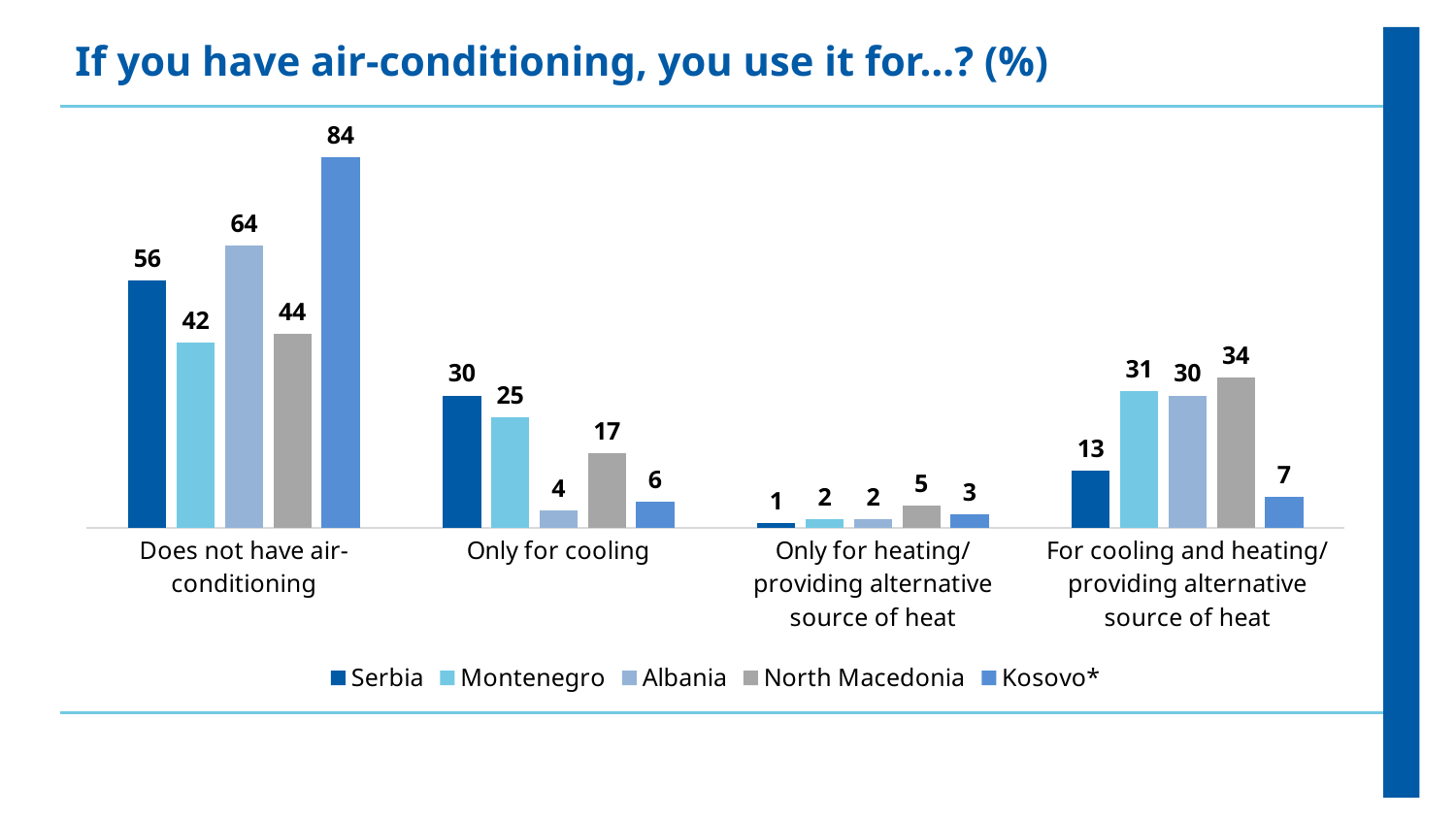
What is the value for North Macedonia in the 'For cooling and heating/ providing alternative source of heat' category? 34 What is the title of the chart? If you have air-conditioning, you use it for...? (%) What is the value for Kosovo* in the 'Does not have air-conditioning' category? 84 What is the difference between Serbia and Albania in the 'Does not have air-conditioning' category? 8 What kind of chart is shown on the slide? Bar chart How many categories are shown on the x axis? 4 How many series does the legend list? 5 Which country has the lowest value in the 'Only for cooling' category? Albania What is the value for Serbia in the 'Only for heating/ providing alternative source of heat' category? 1 What is the value for Montenegro in the 'Only for cooling' category? 25 Which country has the highest value in the 'Does not have air-conditioning' category? Kosovo* Which is larger in the 'For cooling and heating/ providing alternative source of heat' category: Serbia or Montenegro? Montenegro